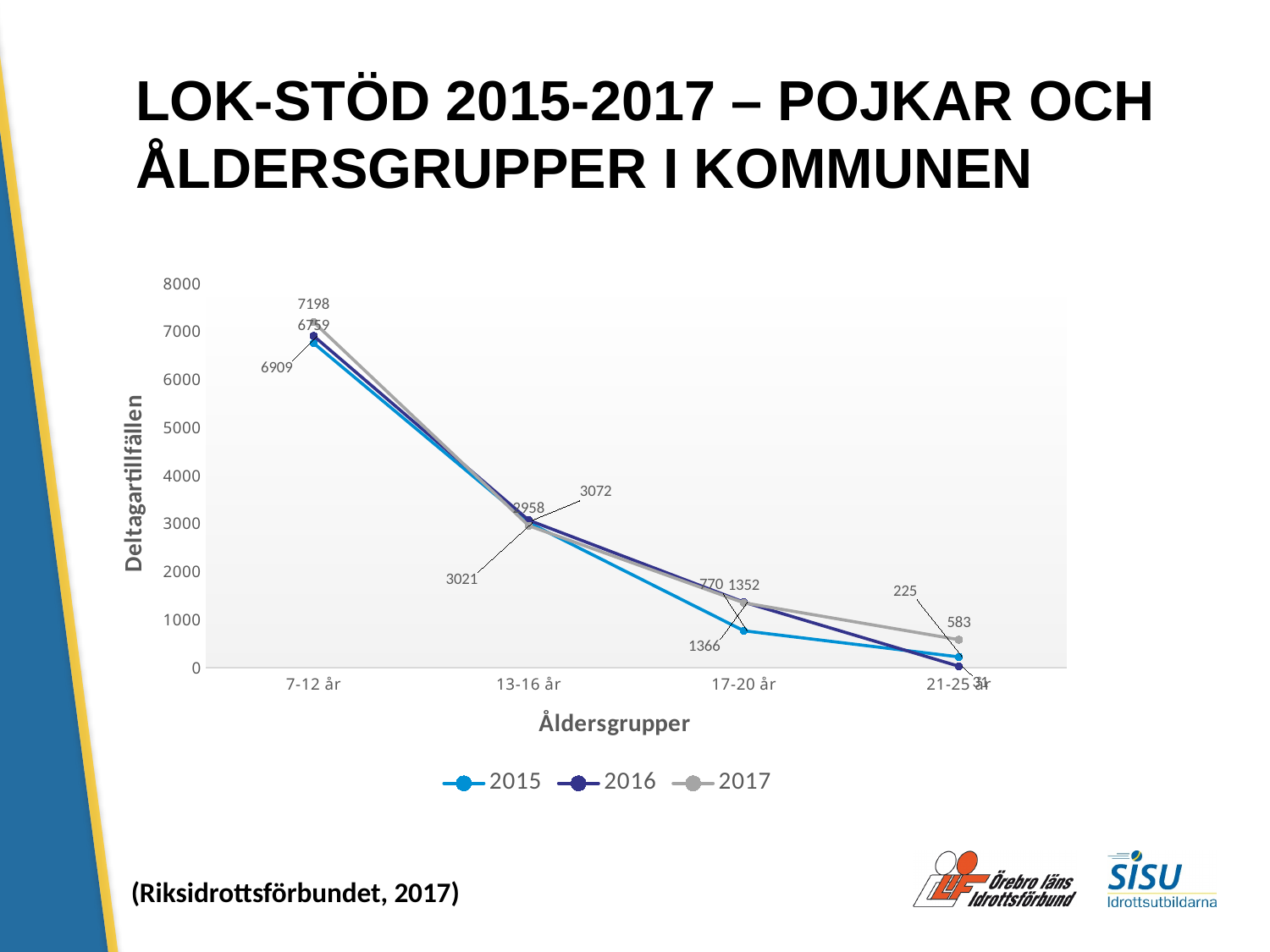
What kind of chart is shown on the slide? Line chart How many age groups are shown on the x axis? 4 What is the value for 2015 in the 17-20 år age group? 770 What is the value for 2017 in the 7-12 år age group? 7198 What is the value for 2016 in the 21-25 år age group? 31 Do the values rise or fall from the 7-12 år group to the 21-25 år group? Fall How many series does the legend list? 3 What is the difference between the 2017 values for 7-12 år and 21-25 år? 6615 Which series has the lowest value in the 21-25 år age group? 2016 What is the title of the y axis? Deltagartillfällen Which age group has the highest value for the 2017 series? 7-12 år What is the value for 2017 in the 21-25 år age group? 583